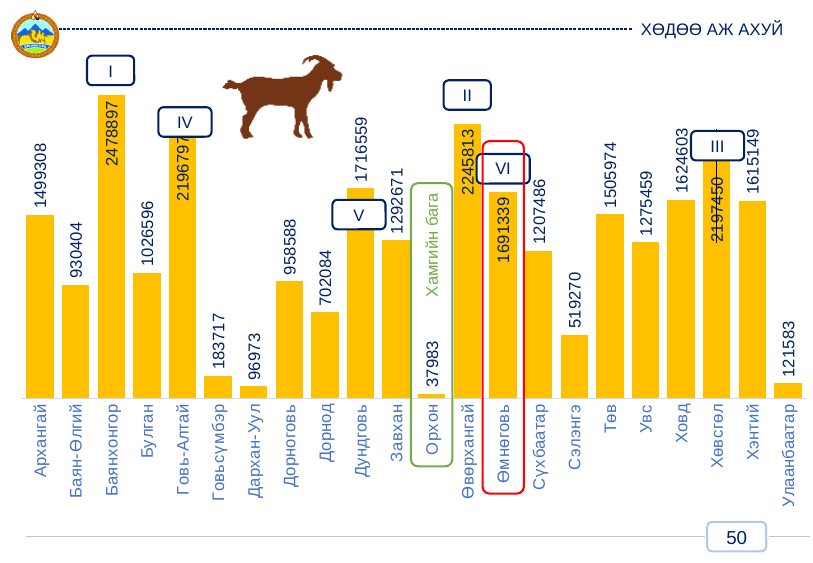
What is the difference between the values for Баянхонгор and Өвөрхангай? 233084 How many provinces (categories) are plotted in the chart? 22 Which province is marked with the label "Хамгийн бага" on the chart? Орхон Which has a larger value, Дорноговь or Дорнод? Дорноговь What is the value shown for Улаанбаатар? 121583 What is the value shown for Баянхонгор? 2478897 Which province has the lowest value in the chart? Орхон What type of chart is shown on the slide? Bar chart What is the difference between the values for Дундговь and Өмнөговь? 25220 Which province has the highest value in the chart? Баянхонгор What is the value shown for Орхон? 37983 What is the value shown for Өмнөговь? 1691339